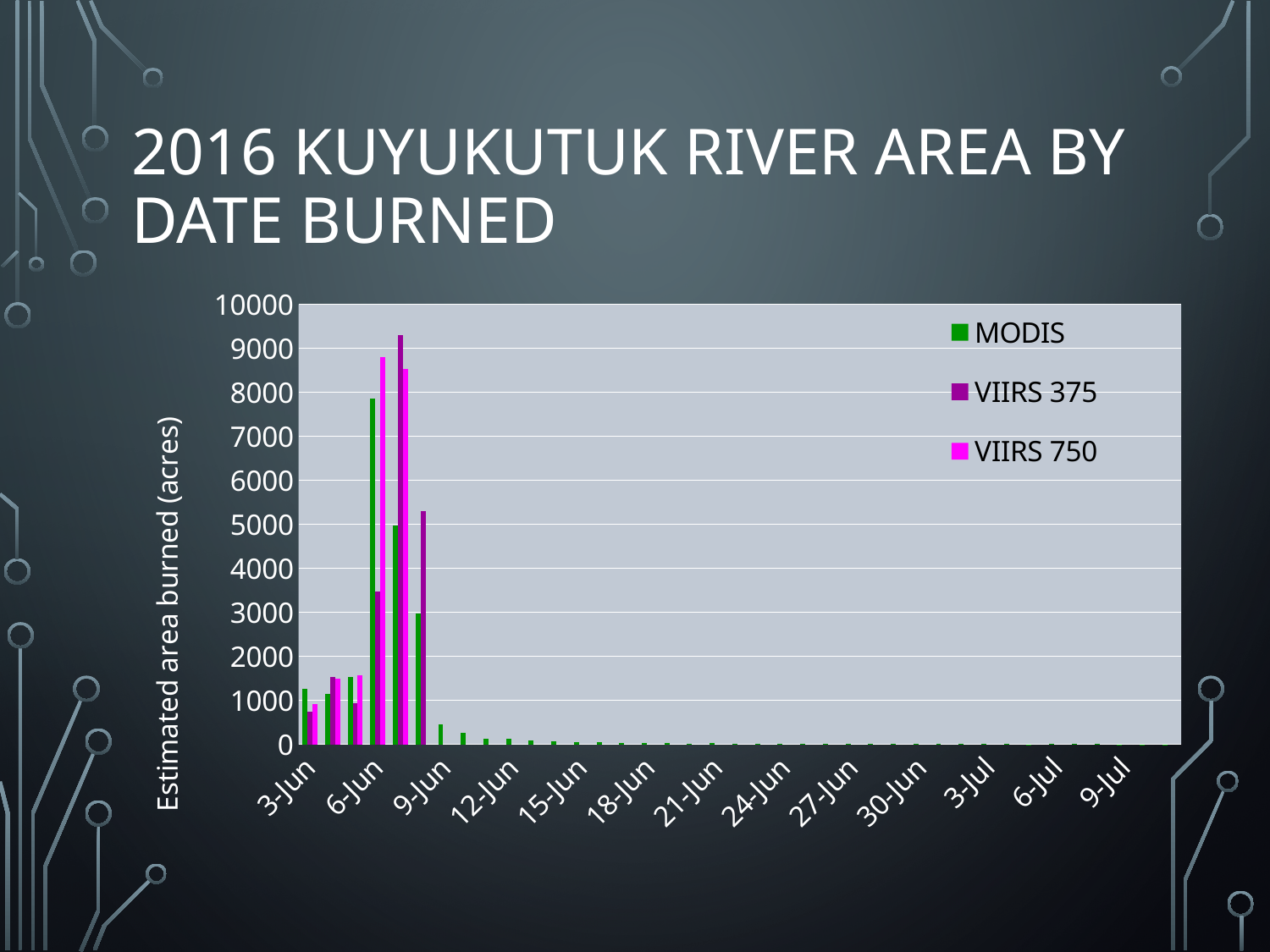
Which is taller: the tallest MODIS bar or the tallest VIIRS 750 bar? VIIRS 750 What are the three series named in the legend? MODIS, VIIRS 375, VIIRS 750 Is the tallest VIIRS 375 bar greater or less than 9000? greater How many series does the legend list? 3 Which series has the single tallest bar in the chart? VIIRS 375 What kind of chart is shown on the slide? bar chart After the peak in early June, do the estimated area burned values rise or fall along the x axis? fall Which is taller: the tallest VIIRS 375 bar or the tallest MODIS bar? VIIRS 375 Is the tallest VIIRS 750 bar greater or less than 8000? greater What is the title of the vertical axis? Estimated area burned (acres) Is the tallest MODIS bar greater or less than 9000? less